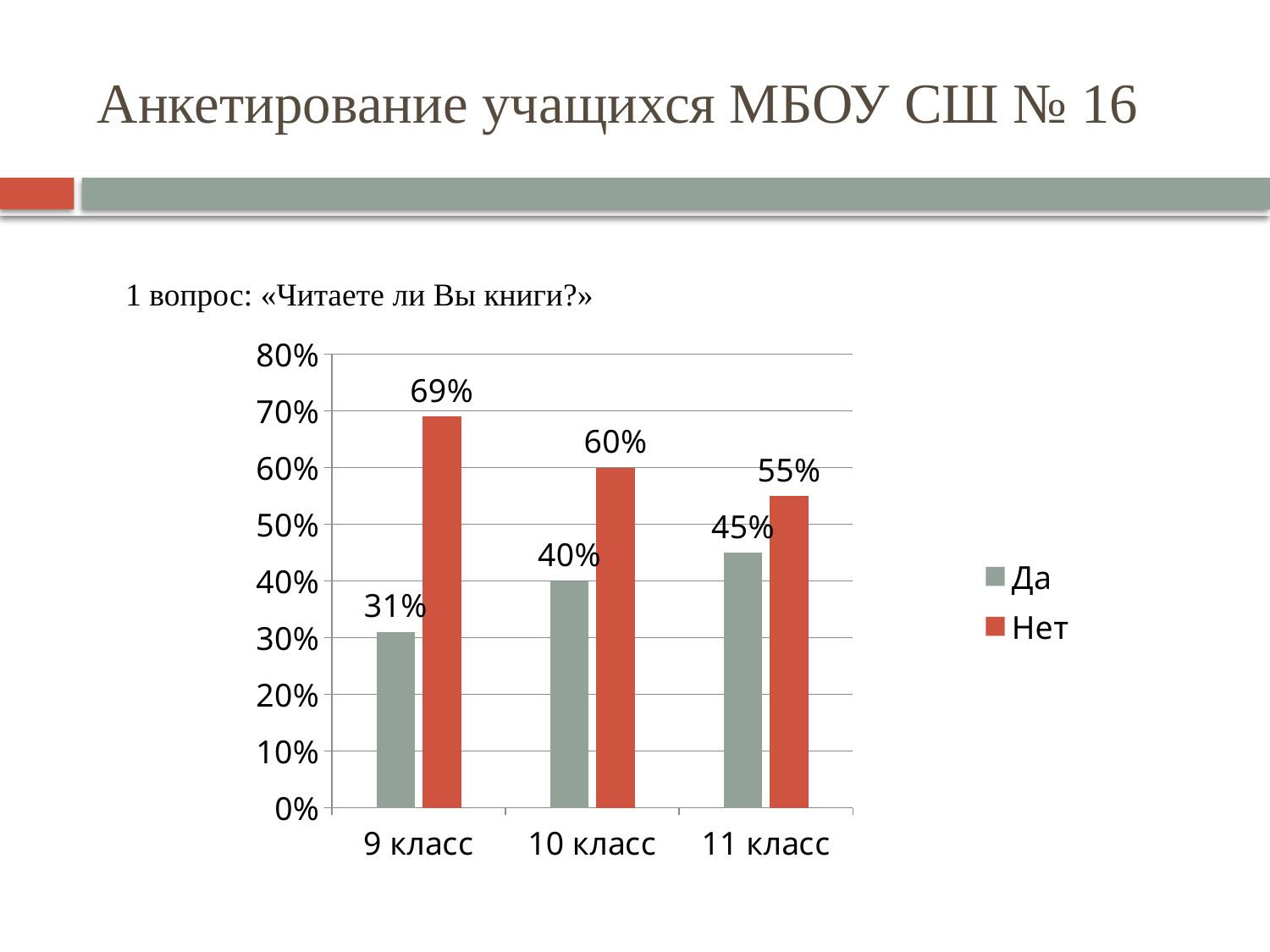
How many series does the legend list? 2 What kind of chart is shown on the slide? Bar chart Which category has the lowest value for "Да"? 9 класс How many categories are shown on the x axis? 3 What is the value for "Нет" in the "10 класс" category? 60% What is the value for "Да" in the "11 класс" category? 45% Which category has the highest value for "Нет"? 9 класс Do the values for "Нет" rise or fall from "9 класс" to "11 класс"? Fall Which is larger in the "11 класс" category, "Да" or "Нет"? Нет What is the difference between "Нет" and "Да" in the "9 класс" category? 38% What is the value for "Да" in the "9 класс" category? 31% What question is the chart about, as written above it? Читаете ли Вы книги?